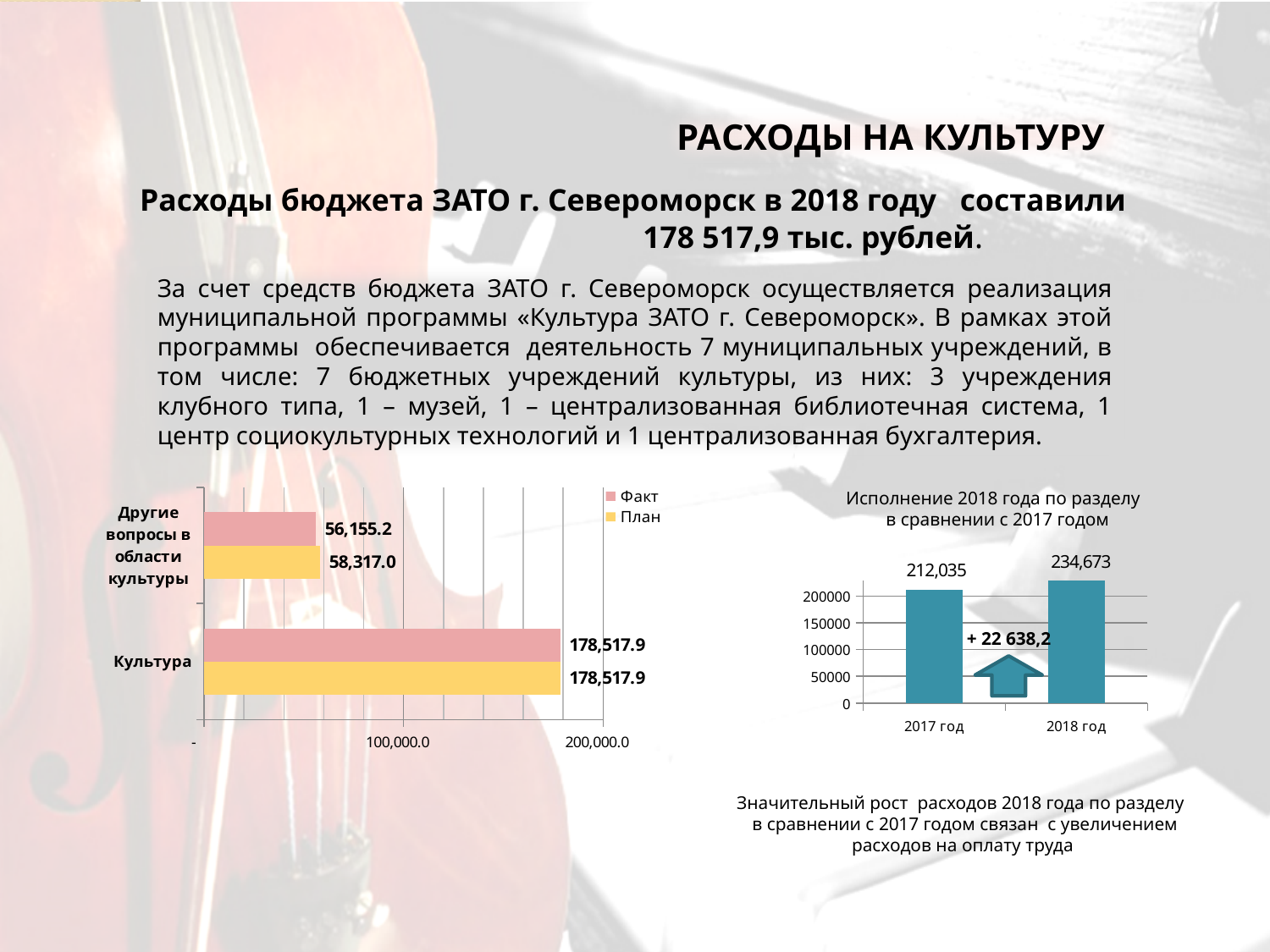
On the left chart, what type of chart is shown? Bar chart On the chart titled 'Исполнение 2018 года по разделу в сравнении с 2017 годом', how many categories are shown on the x axis? 2 On the chart titled 'Исполнение 2018 года по разделу в сравнении с 2017 годом', what is the value for 2017 год? 212,035 On the chart titled 'Исполнение 2018 года по разделу в сравнении с 2017 годом', which year has the higher value? 2018 год On the chart titled 'Исполнение 2018 года по разделу в сравнении с 2017 годом', is the value for 2017 год greater or less than 200000? greater On the left chart, what is the difference between the План and Факт values for Другие вопросы в области культуры? 2,161.8 On the left chart, which category has the higher Факт value, Культура or Другие вопросы в области культуры? Культура On the left chart, what is the План value for Другие вопросы в области культуры? 58,317.0 On the left chart, what is the Факт value for Другие вопросы в области культуры? 56,155.2 On the left chart, what is the Факт value for Культура? 178,517.9 On the left chart, how many series does the legend list? 2 On the chart titled 'Исполнение 2018 года по разделу в сравнении с 2017 годом', what is the value for 2018 год? 234,673